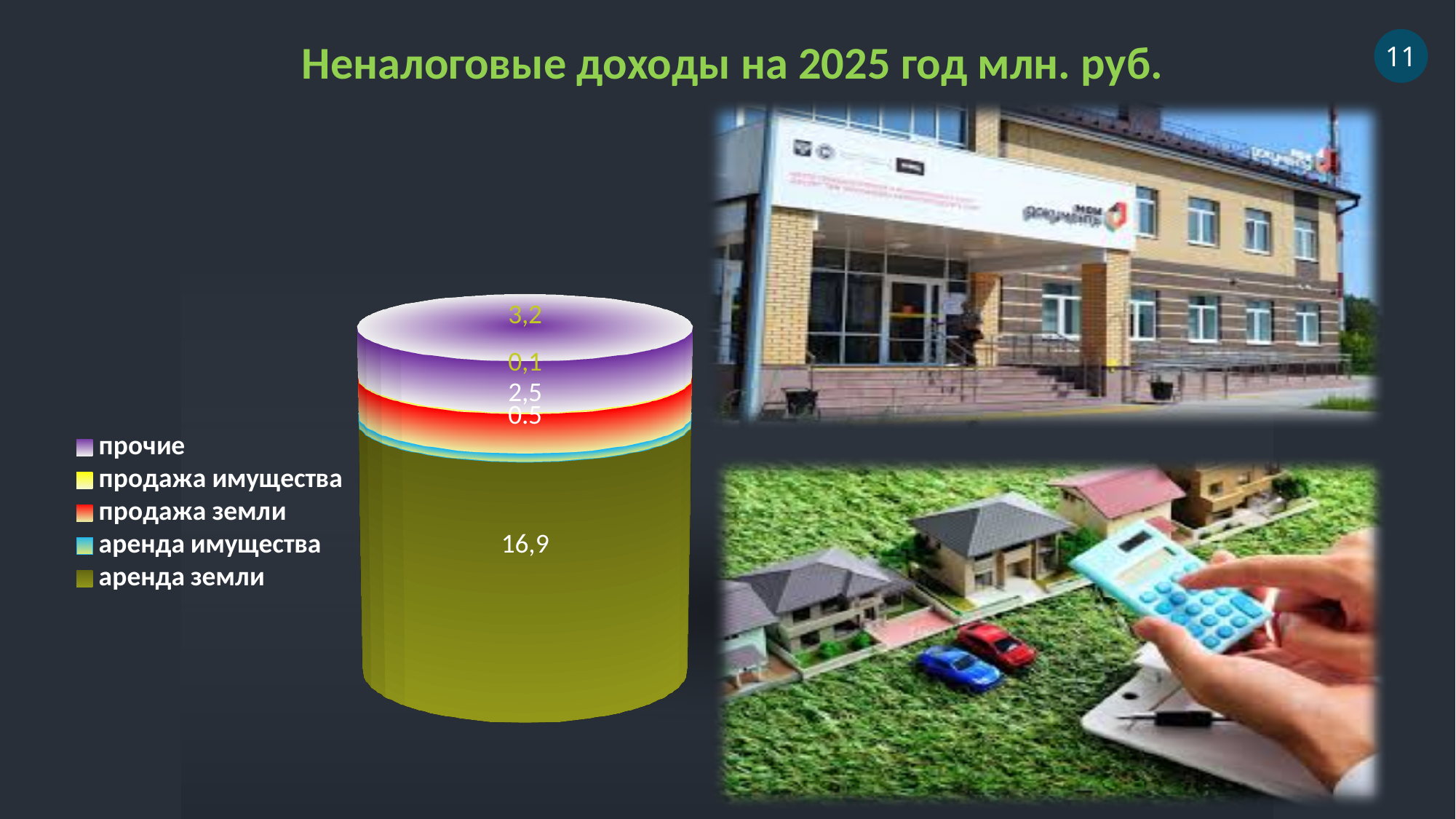
What is the value for продажа земли? 2,5 What is the value for аренда имущества? 0,5 Which category has the highest value? аренда земли Which is larger, the value for продажа земли or the value for аренда имущества? продажа земли Which category has the lowest value? продажа имущества What is the title of the chart? Неналоговые доходы на 2025 год млн. руб. What is the value for прочие? 3,2 How many series does the legend list? 5 What is the total of the stacked bar? 23,2 What is the value for аренда земли? 16,9 What is the difference between the values for аренда земли and прочие? 13,7 What is the value for продажа имущества? 0,1